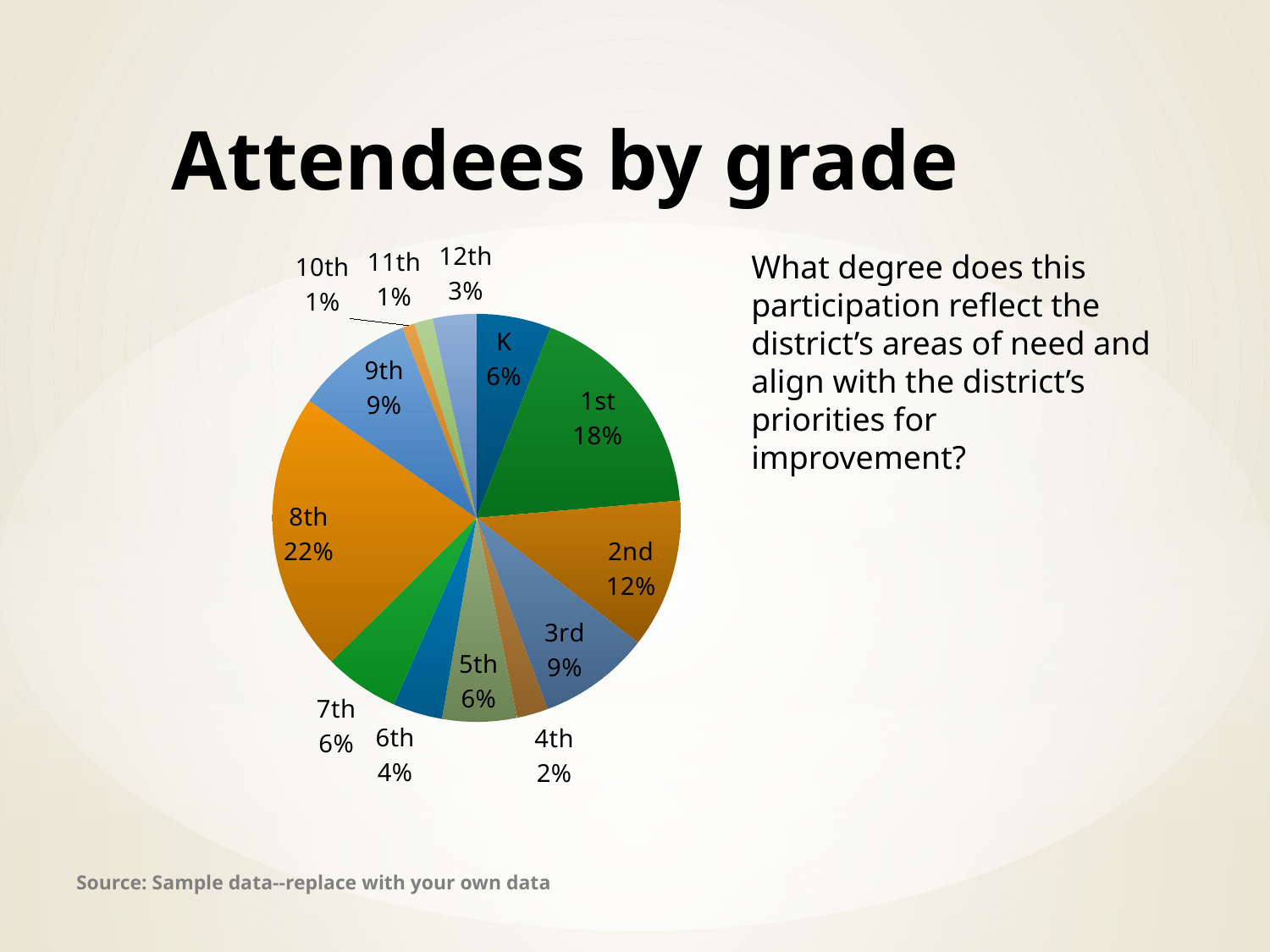
What is the title of the chart? Attendees by grade How many grade categories are shown in the pie chart? 13 Which has a larger share, 3rd grade or 4th grade? 3rd What kind of chart is shown on the slide? pie chart What share of attendees are in 1st grade? 18% Which grade has the largest share of attendees? 8th What is the difference in percentage points between 1st grade and 2nd grade? 6 Which has a larger share, 9th grade or 6th grade? 9th What is the difference in percentage points between 8th grade and 9th grade? 13 What percentage is shown for 12th grade? 3% What percentage is shown for K (kindergarten)? 6% What share of attendees are in 8th grade? 22%